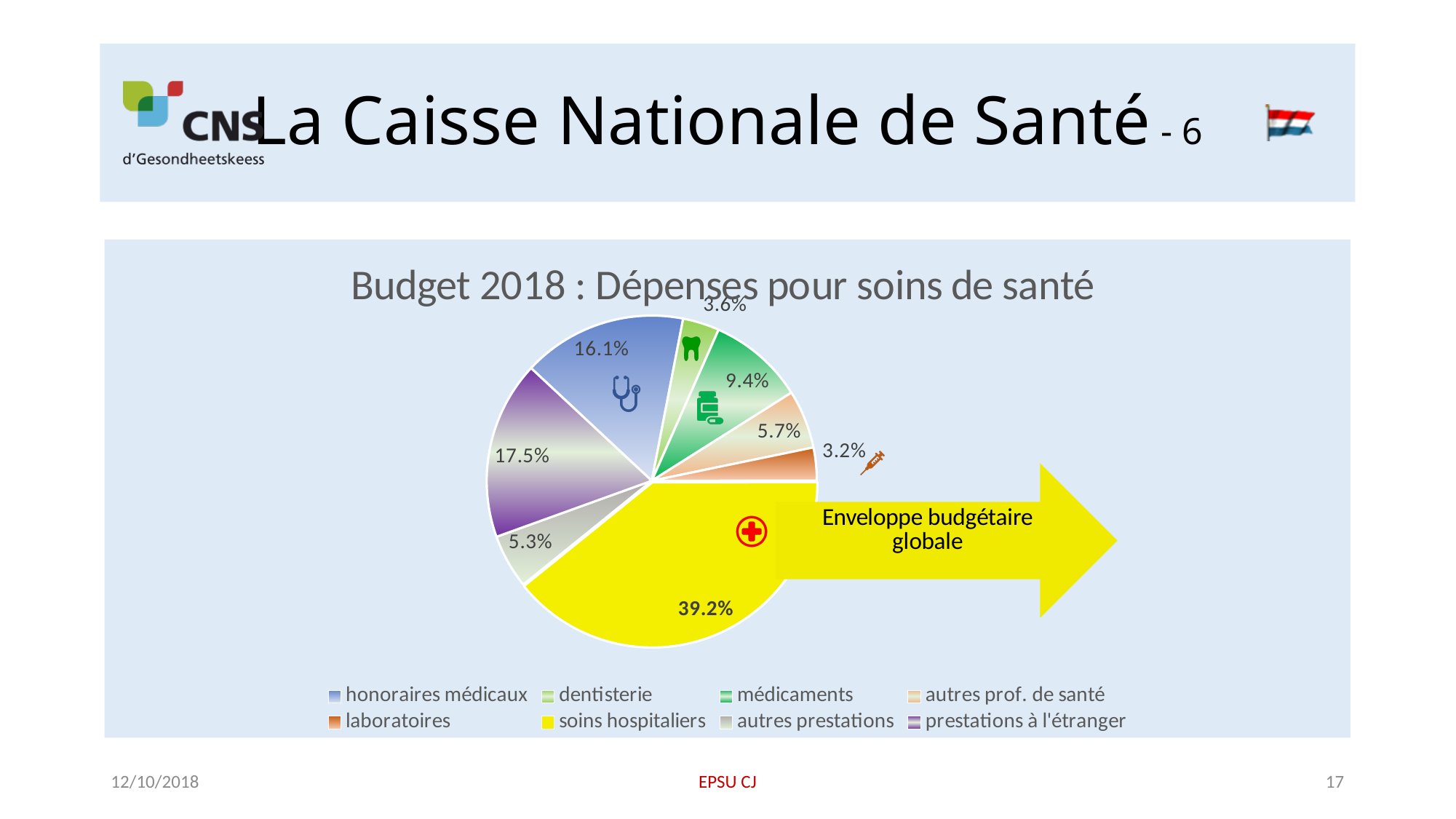
What percentage is shown for médicaments? 9.4% What share of the pie is soins hospitaliers? 39.2% Which category has the largest share of the pie? soins hospitaliers Which is larger, the share for dentisterie or the share for autres prof. de santé? autres prof. de santé What is the title of the chart? Budget 2018 : Dépenses pour soins de santé What type of chart is shown on the slide? pie chart What percentage is shown for honoraires médicaux? 16.1% How many categories does the legend list? 8 Which category has the smallest share of the pie? laboratoires What is the difference in percentage points between prestations à l'étranger and honoraires médicaux? 1.4 What percentage is shown for prestations à l'étranger? 17.5% What percentage is shown for laboratoires? 3.2%